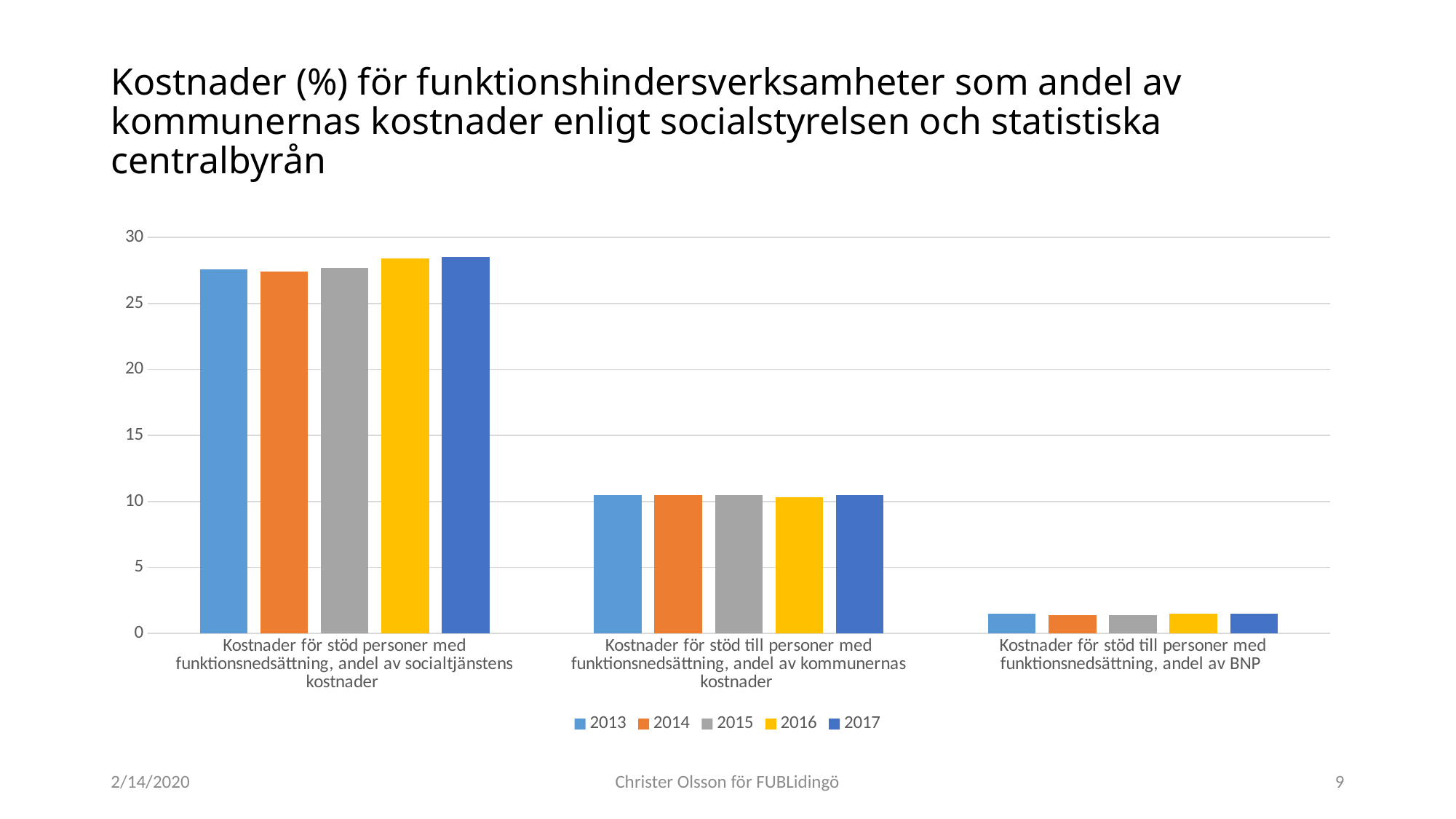
Which category has the highest bars in the chart? Kostnader för stöd personer med funktionsnedsättning, andel av socialtjänstens kostnader Which colour represents the 2016 series in the chart? yellow Is the 2017 value for 'andel av socialtjänstens kostnader' greater or less than 25? greater Is the 2016 value for 'andel av BNP' greater or less than 5? less Which is larger: the 2014 value for 'andel av socialtjänstens kostnader' or the 2014 value for 'andel av kommunernas kostnader'? andel av socialtjänstens kostnader Is the 2013 value for 'andel av socialtjänstens kostnader' greater or less than 30? less Which years are listed in the chart's legend? 2013, 2014, 2015, 2016, 2017 How many series does the legend list? 5 Which category has the lowest bars in the chart? Kostnader för stöd till personer med funktionsnedsättning, andel av BNP What kind of chart is shown on the slide? bar chart How many categories are shown on the x axis of the chart? 3